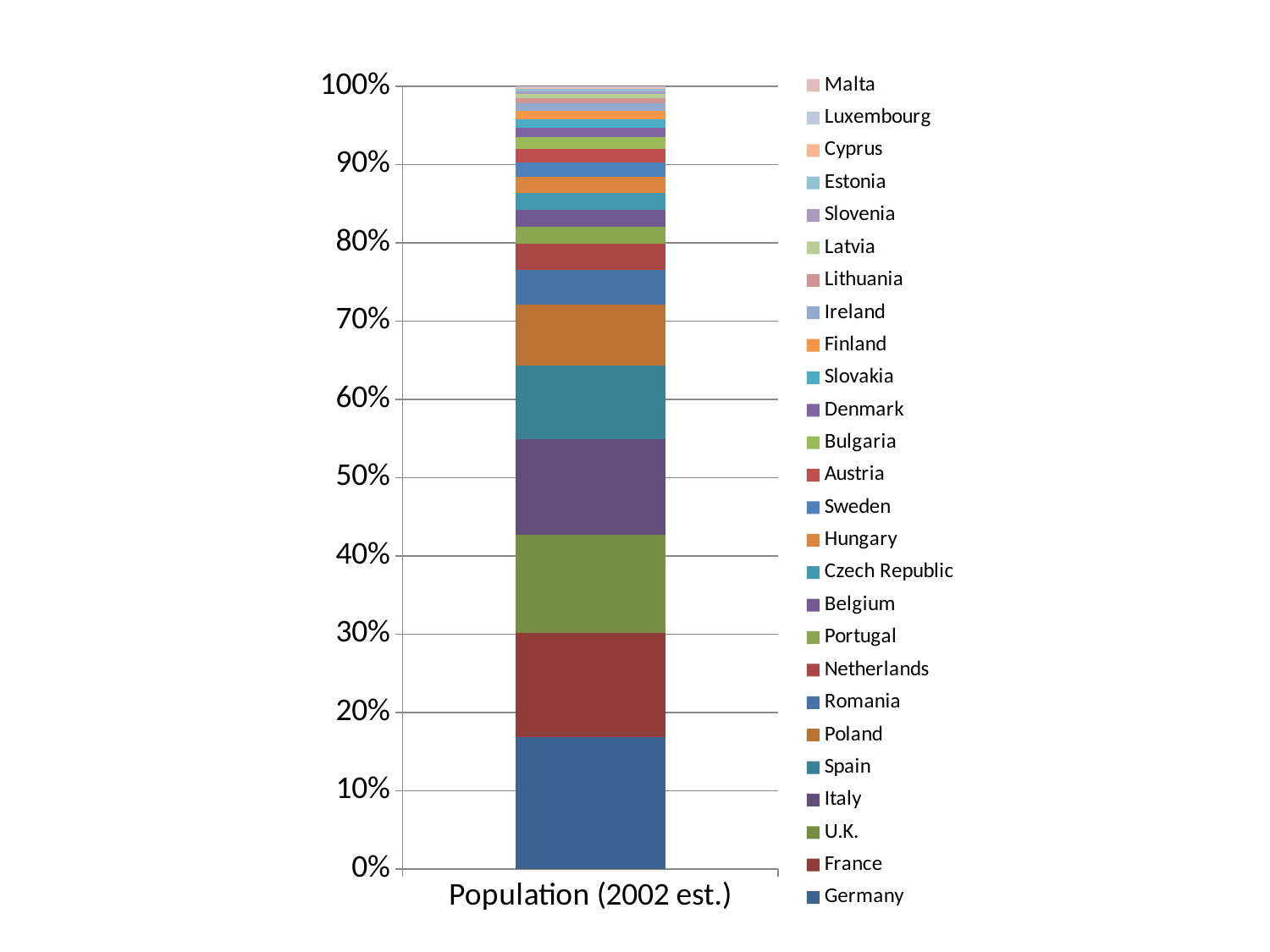
Which is larger, the segment for U.K. or the segment for Netherlands? U.K. What is the label of the single category on the x axis? Population (2002 est.) Is the share for Germany greater or less than 10%? greater Which country occupies the largest segment of the stacked bar? Germany Which is larger, the segment for Italy or the segment for Spain? Italy What kind of chart is shown on the slide? stacked bar chart What is the highest value shown on the y axis? 100% Which is larger, the segment for Germany or the segment for Poland? Germany Which country is listed at the bottom of the legend? Germany How many series does the legend list? 26 How many categories are plotted on the x axis? 1 Is the share for Germany greater or less than 20%? less